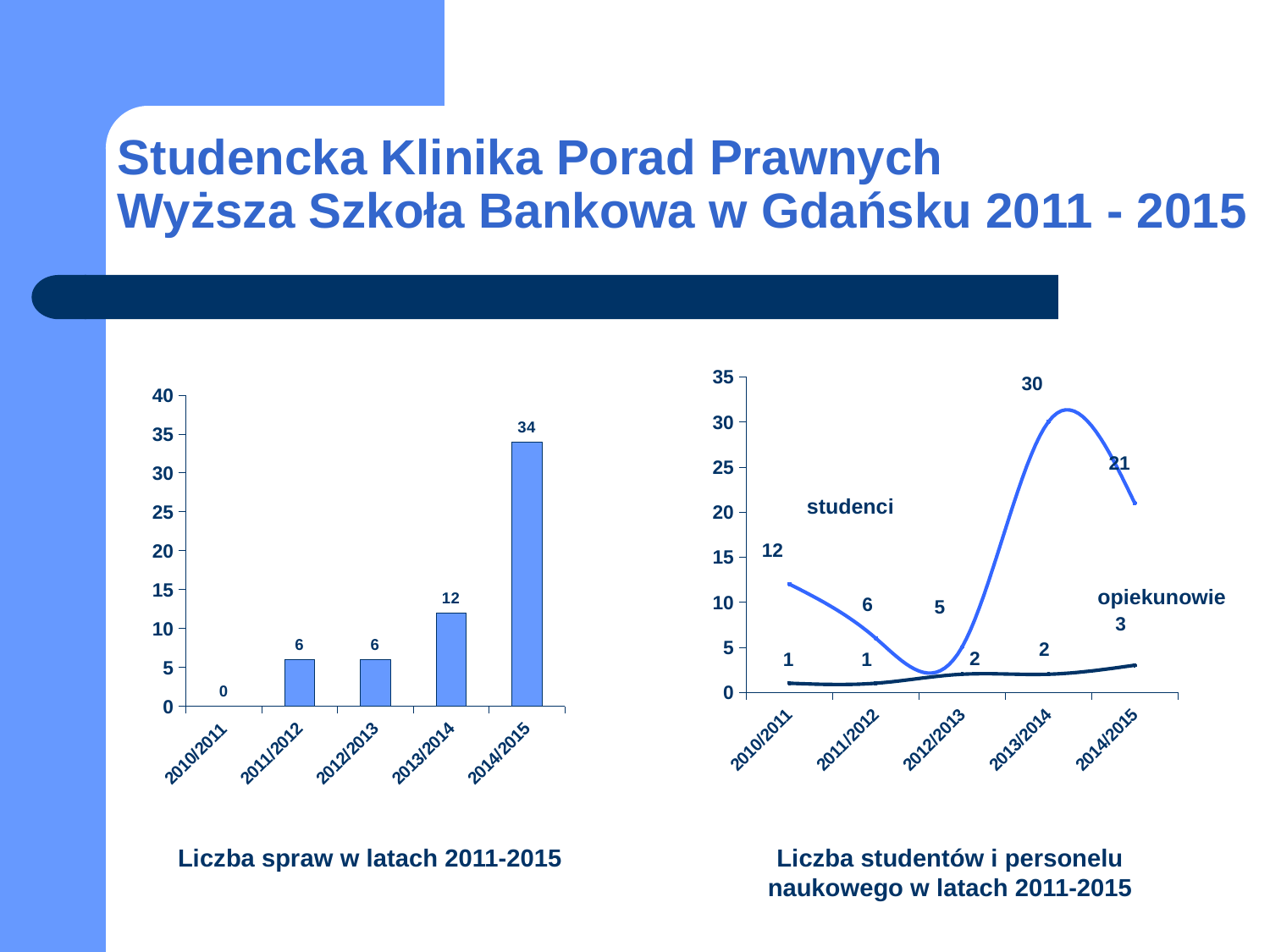
In the right chart (Liczba studentów i personelu naukowego), in which year is the studenci value lowest? 2012/2013 In the right chart (Liczba studentów i personelu naukowego), what is the difference between studenci and opiekunowie in 2014/2015? 18 What kind of chart is the left chart (Liczba spraw w latach 2011-2015)? bar chart In the right chart (Liczba studentów i personelu naukowego), what is the value for opiekunowie in 2014/2015? 3 In the right chart (Liczba studentów i personelu naukowego), which is larger in 2010/2011: studenci or opiekunowie? studenci In the right chart (Liczba studentów i personelu naukowego), what is the value for studenci in 2013/2014? 30 In the left chart (Liczba spraw w latach 2011-2015), how many years are shown on the x axis? 5 In the left chart (Liczba spraw w latach 2011-2015), what is the value for 2014/2015? 34 In the left chart (Liczba spraw w latach 2011-2015), which year has the lowest value? 2010/2011 In the left chart (Liczba spraw w latach 2011-2015), what is the value for 2013/2014? 12 In the left chart (Liczba spraw w latach 2011-2015), what is the difference between the values for 2014/2015 and 2013/2014? 22 What kind of chart is the right chart (Liczba studentów i personelu naukowego)? line chart